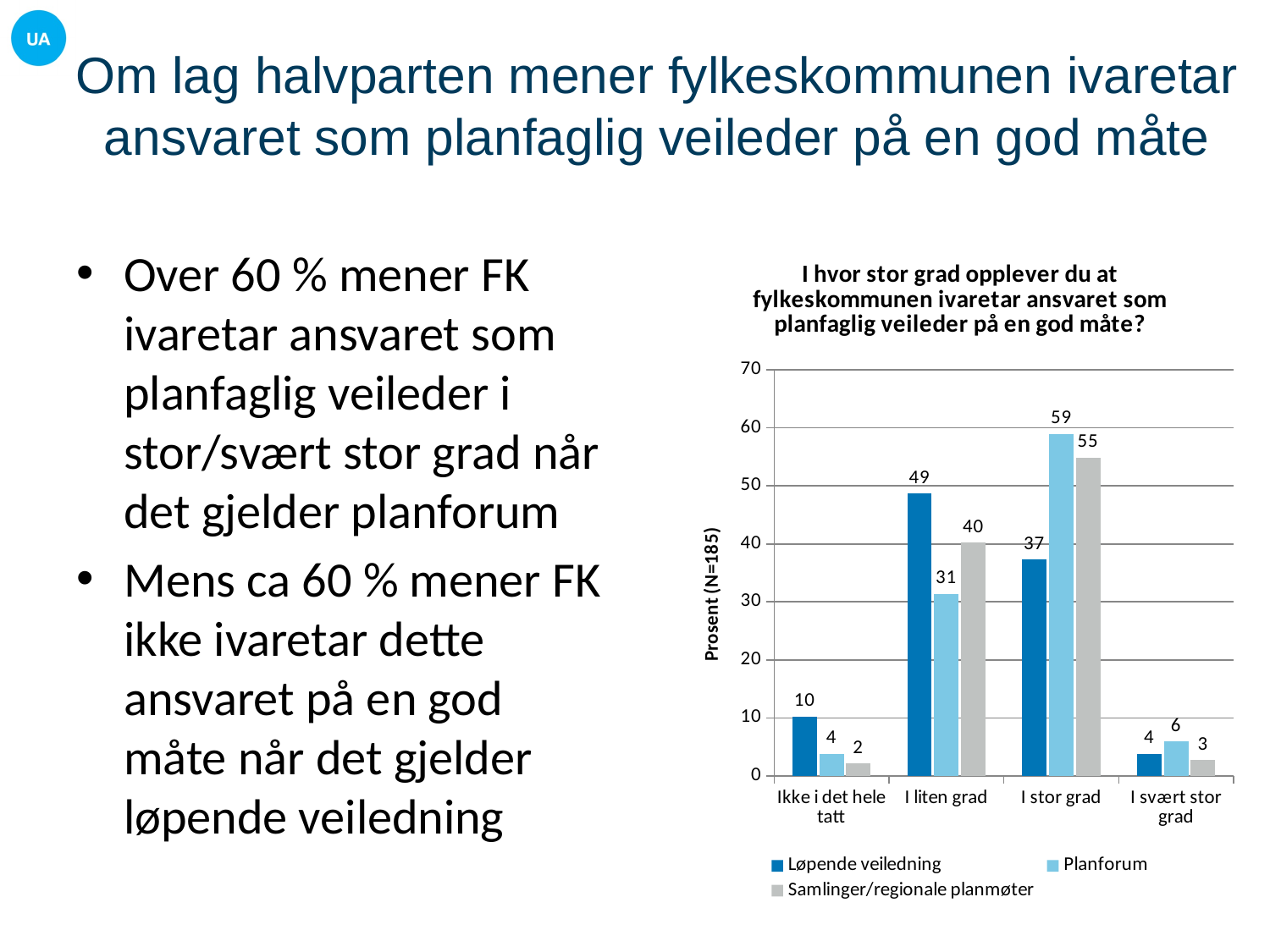
What is the label of the y axis? Prosent (N=185) Which category has the lowest value for Løpende veiledning? I svært stor grad What is the value for Løpende veiledning in the category 'I liten grad'? 49 Which category has the highest value for Planforum? I stor grad What is the difference between the Planforum and Løpende veiledning values in the category 'I stor grad'? 22 How many series does the legend list? 3 What kind of chart is shown on the slide? Bar chart How many categories are shown on the x axis? 4 Which series is shown in grey in the legend? Samlinger/regionale planmøter In the category 'I liten grad', which series has the larger value: Løpende veiledning or Samlinger/regionale planmøter? Løpende veiledning What is the value for Planforum in the category 'I stor grad'? 59 What is the value for Samlinger/regionale planmøter in the category 'Ikke i det hele tatt'? 2